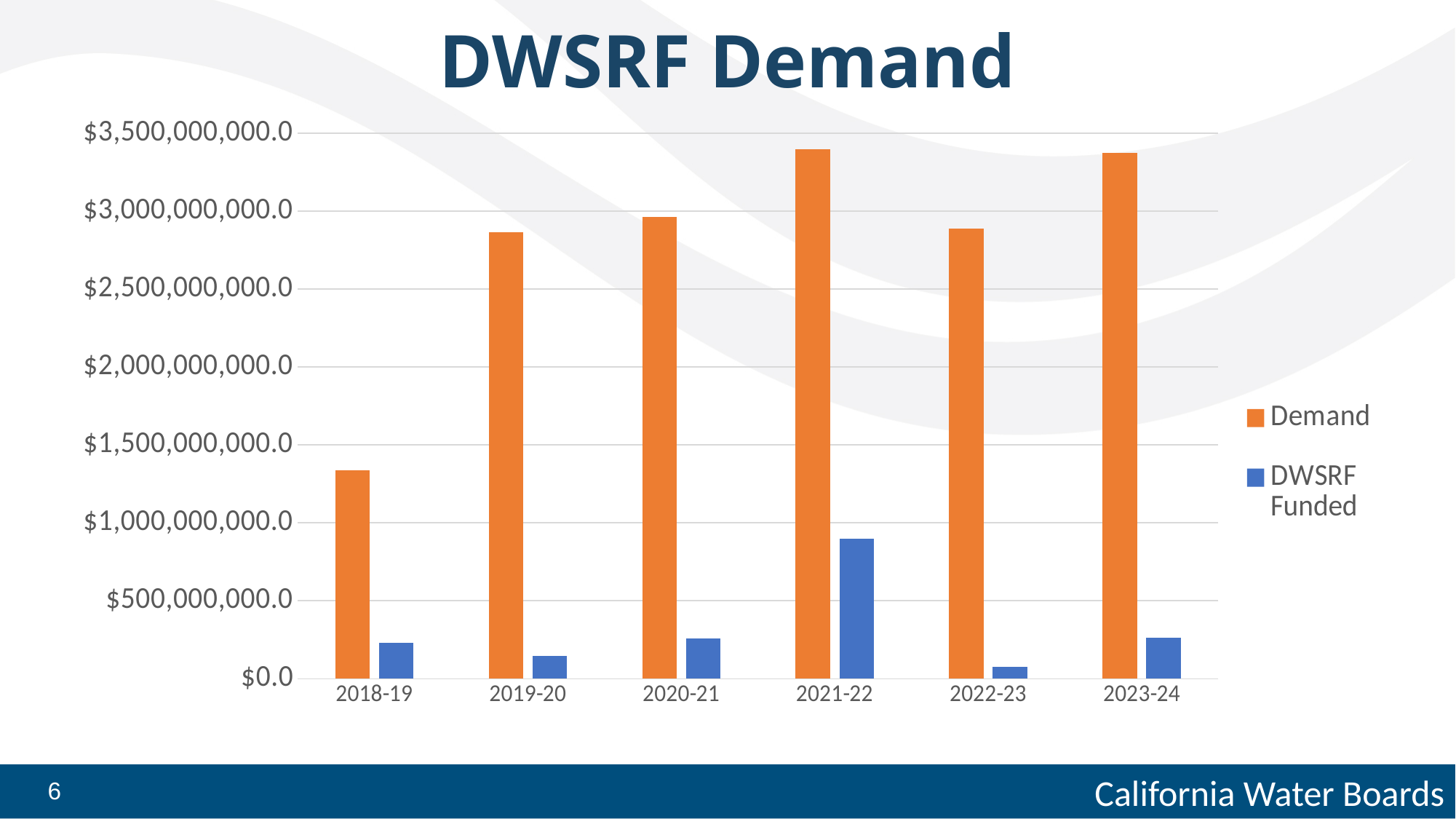
How many fiscal years are shown on the x axis? 6 Which fiscal year has the lowest Demand value? 2018-19 Which fiscal year has the lowest DWSRF Funded value? 2022-23 Is the DWSRF Funded value for 2021-22 greater or less than $1,000,000,000.0? less Is the Demand value for 2021-22 greater or less than $3,000,000,000.0? greater What kind of chart is shown on the slide? bar chart Is the Demand value for 2018-19 greater or less than $1,500,000,000.0? less Does the Demand value rise or fall from 2018-19 to 2021-22? rise How many series does the legend list? 2 Which is larger, the DWSRF Funded value for 2020-21 or for 2019-20? 2020-21 Which fiscal year has the highest DWSRF Funded value? 2021-22